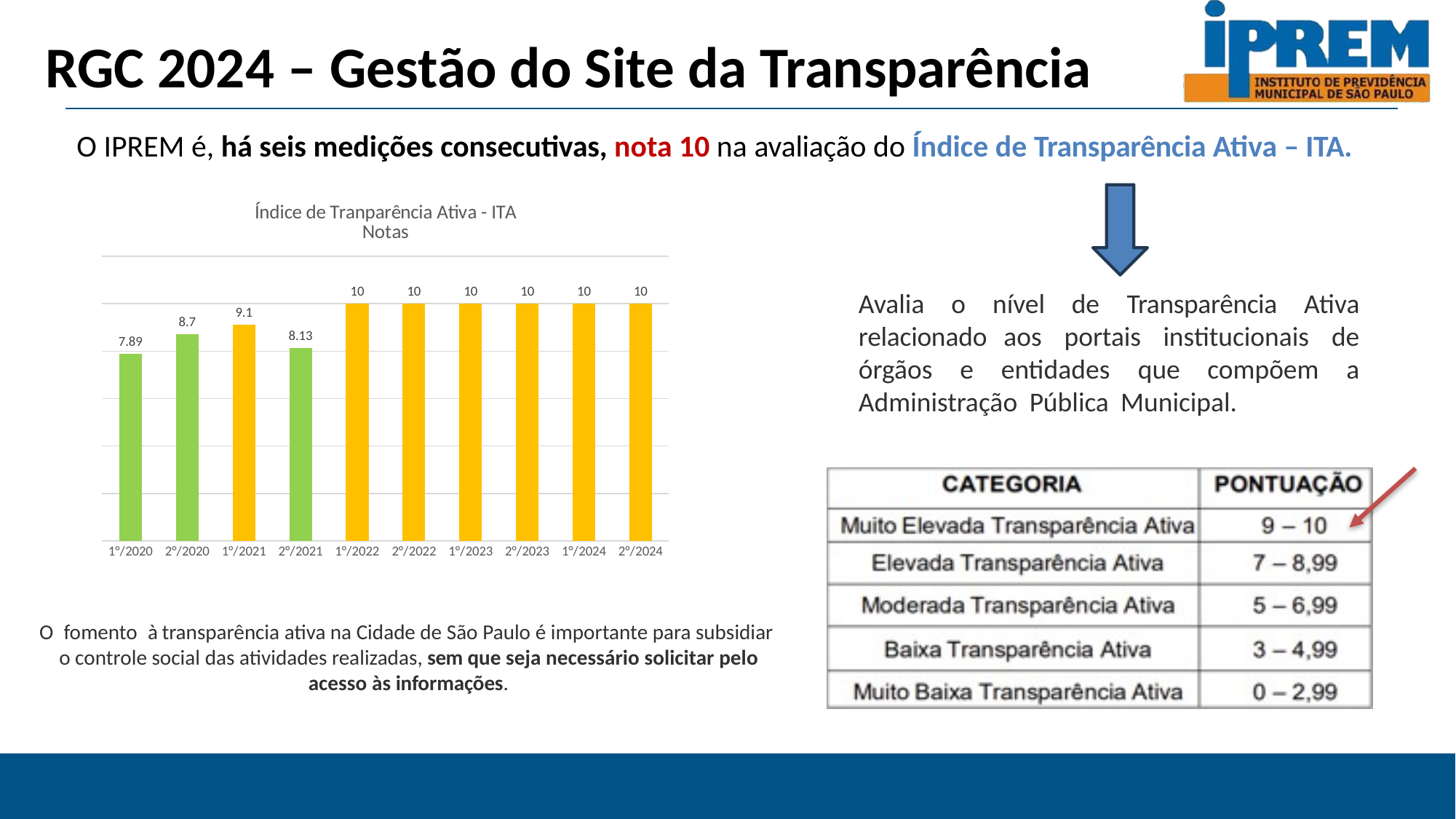
Which is larger, the value for 2°/2020 or the value for 2°/2021? 2°/2020 What is the value for 2°/2020 in the chart? 8.7 What is the title of the chart on the slide? Índice de Tranparência Ativa - ITA Notas Which period has the lowest value in the chart? 1°/2020 What is the value for 1°/2020 in the Índice de Tranparência Ativa - ITA Notas chart? 7.89 What is the value for 1°/2021 in the chart? 9.1 What is the difference between the values for 1°/2021 and 2°/2021? 0.97 What is the value for 2°/2024 in the chart? 10 How many periods are shown on the x axis of the chart? 10 What is the value for 2°/2021 in the chart? 8.13 What kind of chart is shown on the slide? Bar chart What is the difference between the values for 1°/2022 and 1°/2020? 2.11